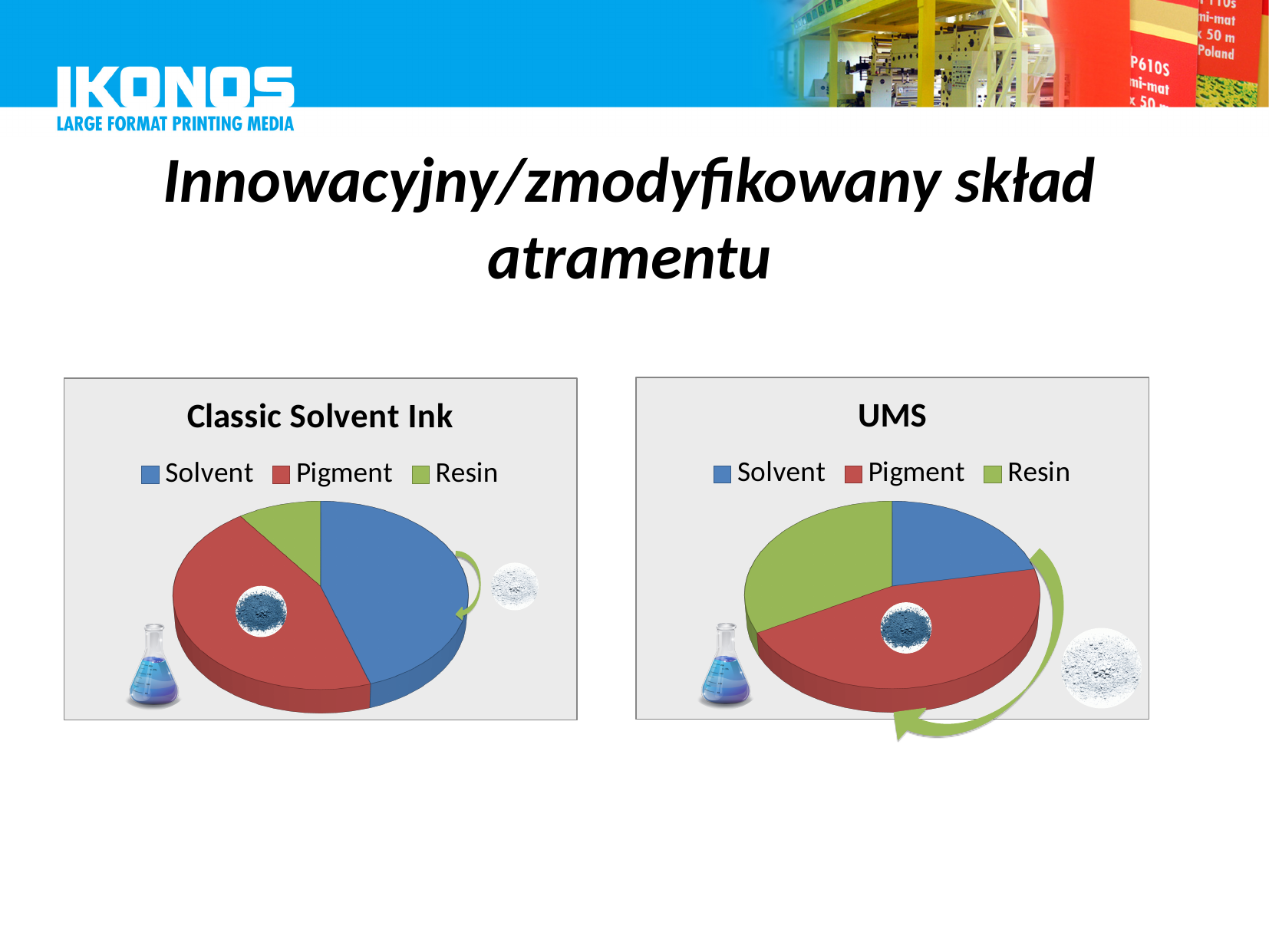
In the UMS chart, which slice is larger, Resin or Solvent? Resin In the UMS chart, which component has the largest slice? Pigment In the Classic Solvent Ink chart, which slice is larger, Pigment or Resin? Pigment What kind of chart is the UMS chart? pie chart In the UMS chart, how many categories does the legend list? 3 In the UMS chart, which component has the smallest slice? Solvent What is the title of the pie chart on the right side of the slide? UMS In the Classic Solvent Ink chart, which component has the smallest slice? Resin What kind of chart is the Classic Solvent Ink chart? pie chart In the Classic Solvent Ink chart, how many slices does the pie have? 3 In the Classic Solvent Ink chart, which colour represents Resin in the legend? green